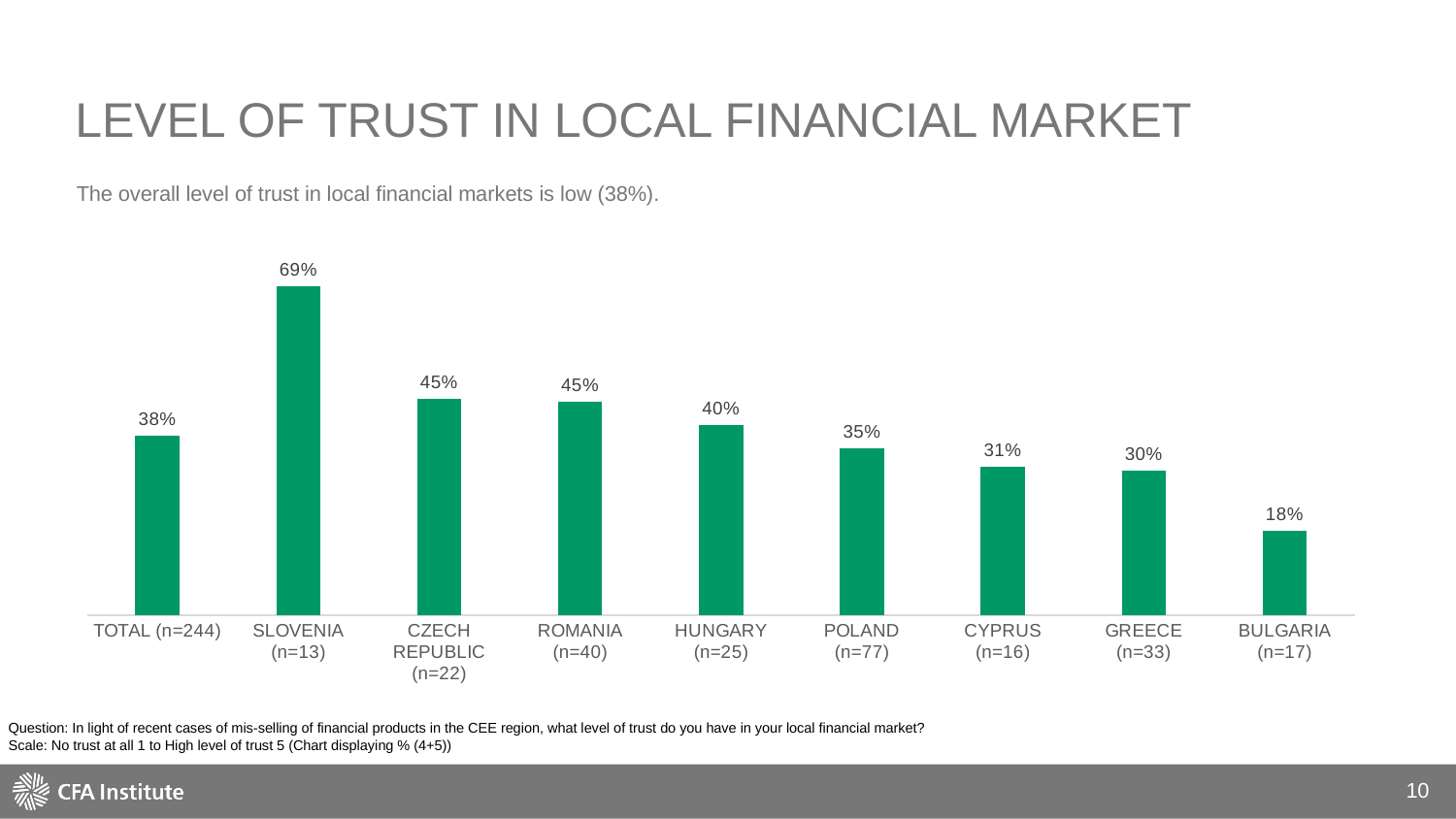
What is the value for Poland? 35% What is the difference between the values for Hungary and Greece? 10% What is the value for Slovenia? 69% What is the value for Total (n=244)? 38% How many bars are shown in the chart? 9 Which country has the highest level of trust? Slovenia What is the title of the slide? LEVEL OF TRUST IN LOCAL FINANCIAL MARKET What is the value for Bulgaria? 18% Which country has the lowest level of trust? Bulgaria What kind of chart is shown on the slide? Bar chart Which is larger, the value for Cyprus or the value for Poland? Poland What is the difference between the values for Slovenia and Bulgaria? 51%